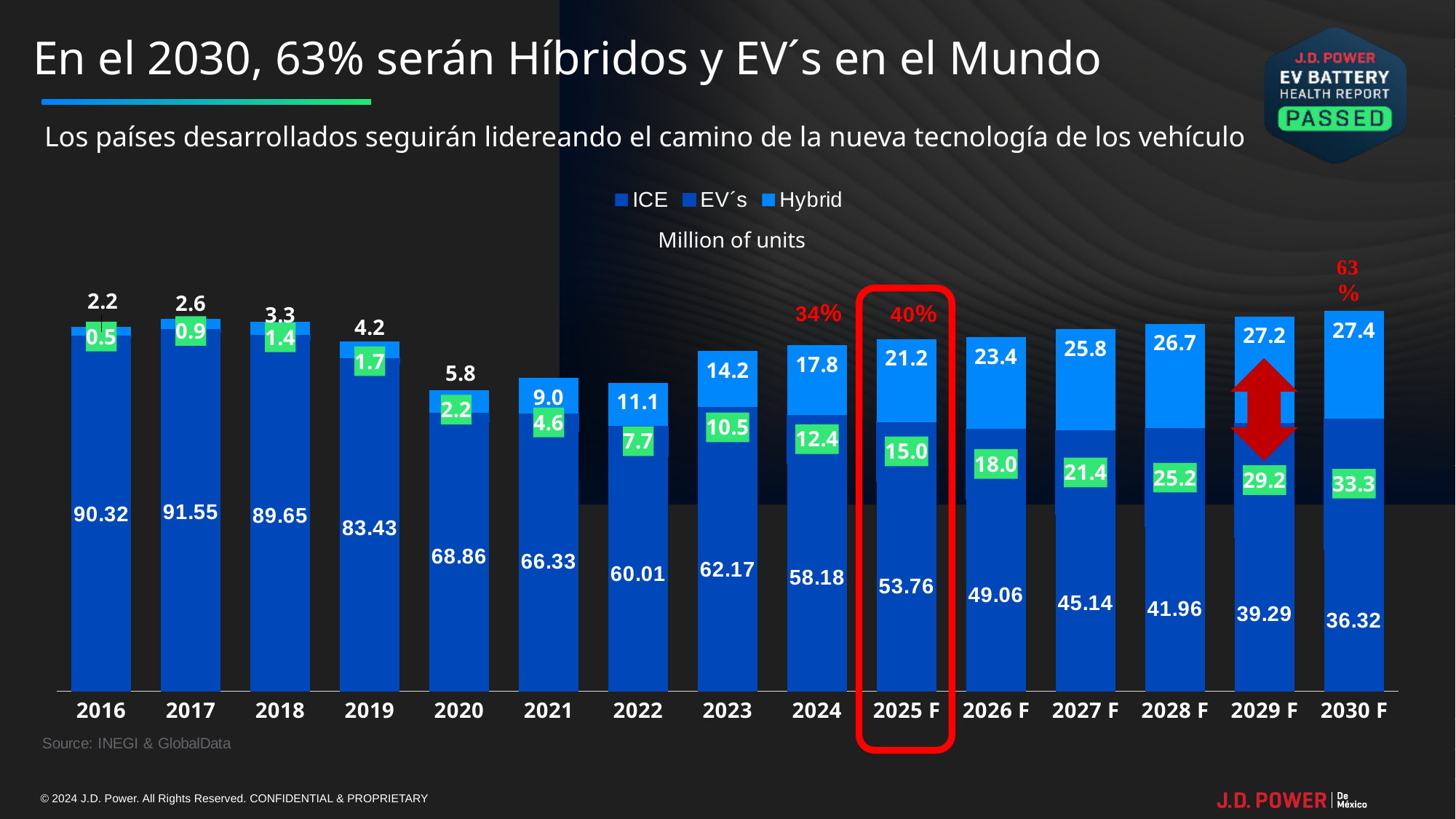
What is the total of the stacked bar for 2025 F? 89.96 What is the ICE value for 2016? 90.32 What kind of chart is shown on the slide? Stacked bar chart Which is larger in 2030 F, the EV´s value or the Hybrid value? EV´s How many years are shown on the x axis? 15 What is the EV´s value for 2025 F? 15.0 Which year has the highest ICE value? 2017 Which year has the lowest ICE value? 2030 F How many series does the legend list? 3 Do the Hybrid values rise or fall from 2016 to 2030 F? Rise What is the Hybrid value for 2030 F? 27.4 What is the difference between the ICE value in 2016 and the ICE value in 2030 F? 54.00